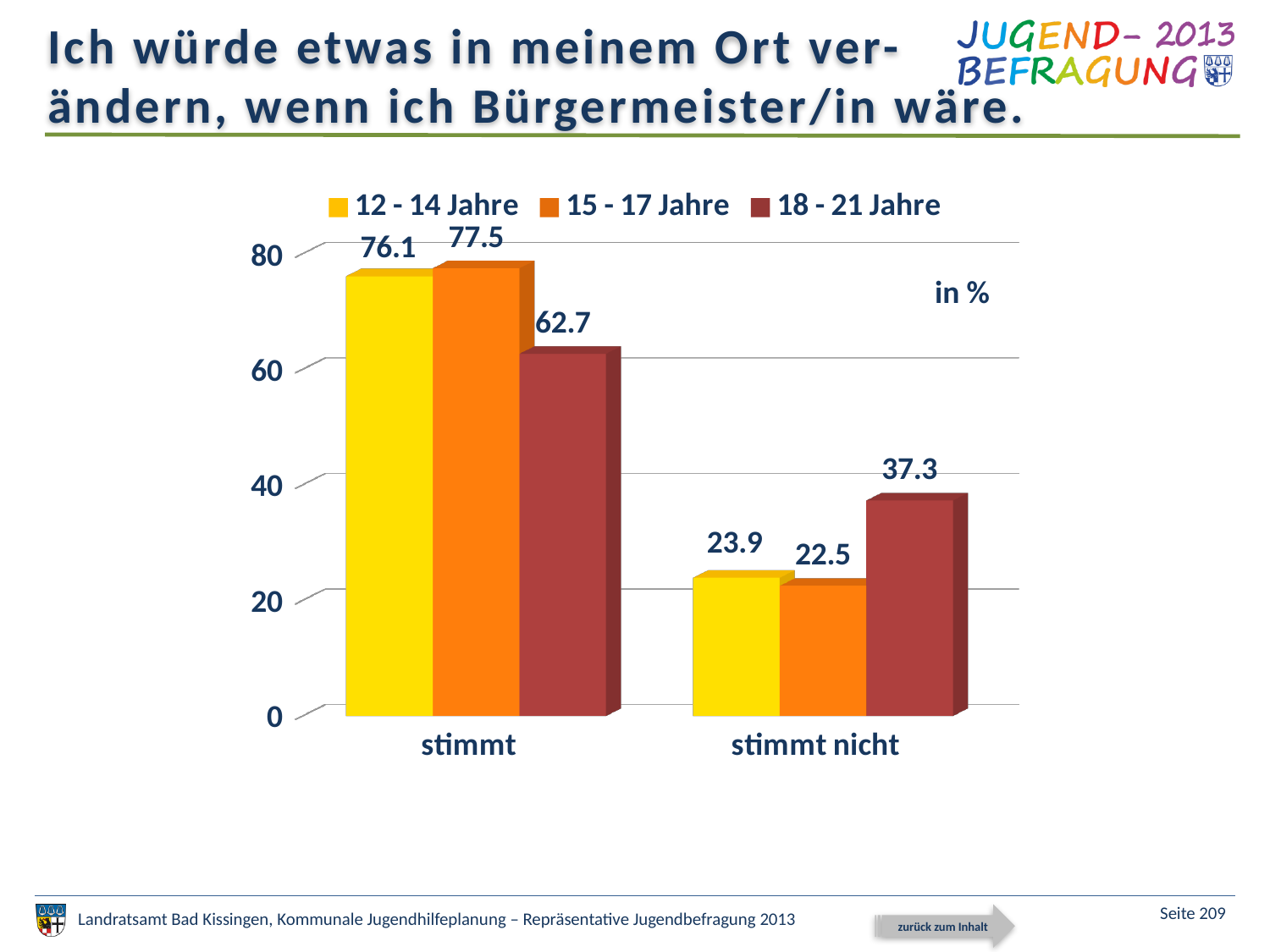
How many categories are shown on the x axis? 2 Which age group has the lowest value in the 'stimmt' category? 18 - 21 Jahre What is the difference between the 18 - 21 Jahre and 12 - 14 Jahre values in the 'stimmt nicht' category? 13.4 What is the value for the 18 - 21 Jahre series in the 'stimmt nicht' category? 37.3 How many series does the legend list? 3 Which is larger: the 12 - 14 Jahre value for 'stimmt nicht' or the 18 - 21 Jahre value for 'stimmt nicht'? 18 - 21 Jahre What is the value for the 12 - 14 Jahre series in the 'stimmt' category? 76.1 What is the value for the 15 - 17 Jahre series in the 'stimmt nicht' category? 22.5 What kind of chart is shown on the slide? bar chart Is the value for 18 - 21 Jahre in the 'stimmt' category greater or less than 60? greater What is the difference between the 15 - 17 Jahre and 18 - 21 Jahre values in the 'stimmt' category? 14.8 Which age group has the highest value in the 'stimmt' category? 15 - 17 Jahre